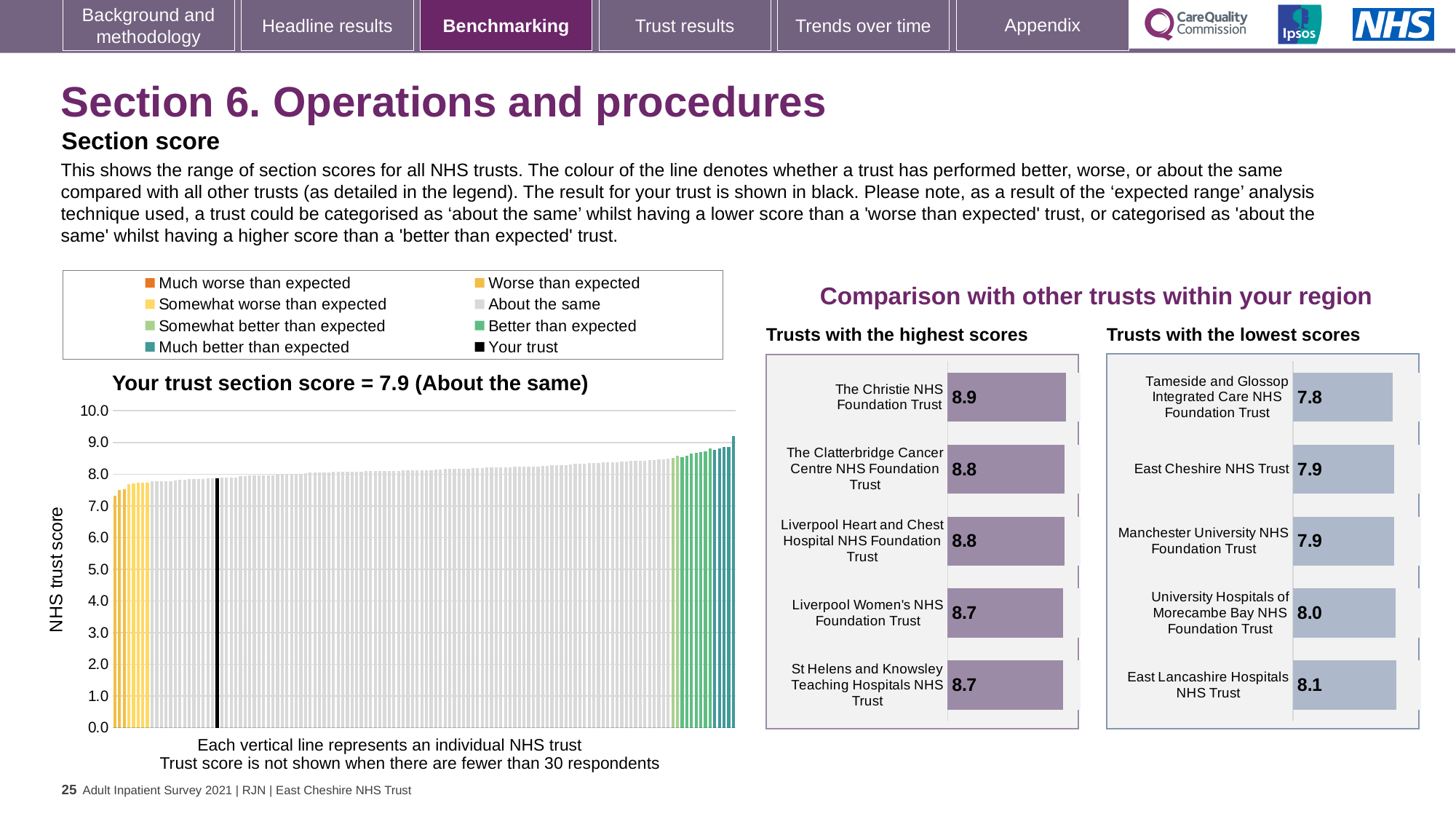
In the 'Trusts with the lowest scores' chart, what is the score for Tameside and Glossop Integrated Care NHS Foundation Trust? 7.8 In the 'Trusts with the highest scores' chart, how many trusts are shown? 5 What kind of chart is the 'Your trust section score' chart? bar chart In the 'Trusts with the highest scores' chart, which trust has the highest score? The Christie NHS Foundation Trust In the 'Your trust section score' chart, what is the section score for your trust? 7.9 In the 'Trusts with the highest scores' chart, what is the score for The Christie NHS Foundation Trust? 8.9 How many entries does the legend above the 'Your trust section score' chart list? 8 In the 'Trusts with the highest scores' chart, what is the difference between the scores of The Christie NHS Foundation Trust and Liverpool Women's NHS Foundation Trust? 0.2 What is the label on the vertical axis of the 'Your trust section score' chart? NHS trust score In the 'Trusts with the lowest scores' chart, which is larger: the score for East Lancashire Hospitals NHS Trust or the score for East Cheshire NHS Trust? East Lancashire Hospitals NHS Trust In the 'Your trust section score' chart, how is your trust's score categorised? About the same In the 'Trusts with the lowest scores' chart, which trust has the lowest score? Tameside and Glossop Integrated Care NHS Foundation Trust